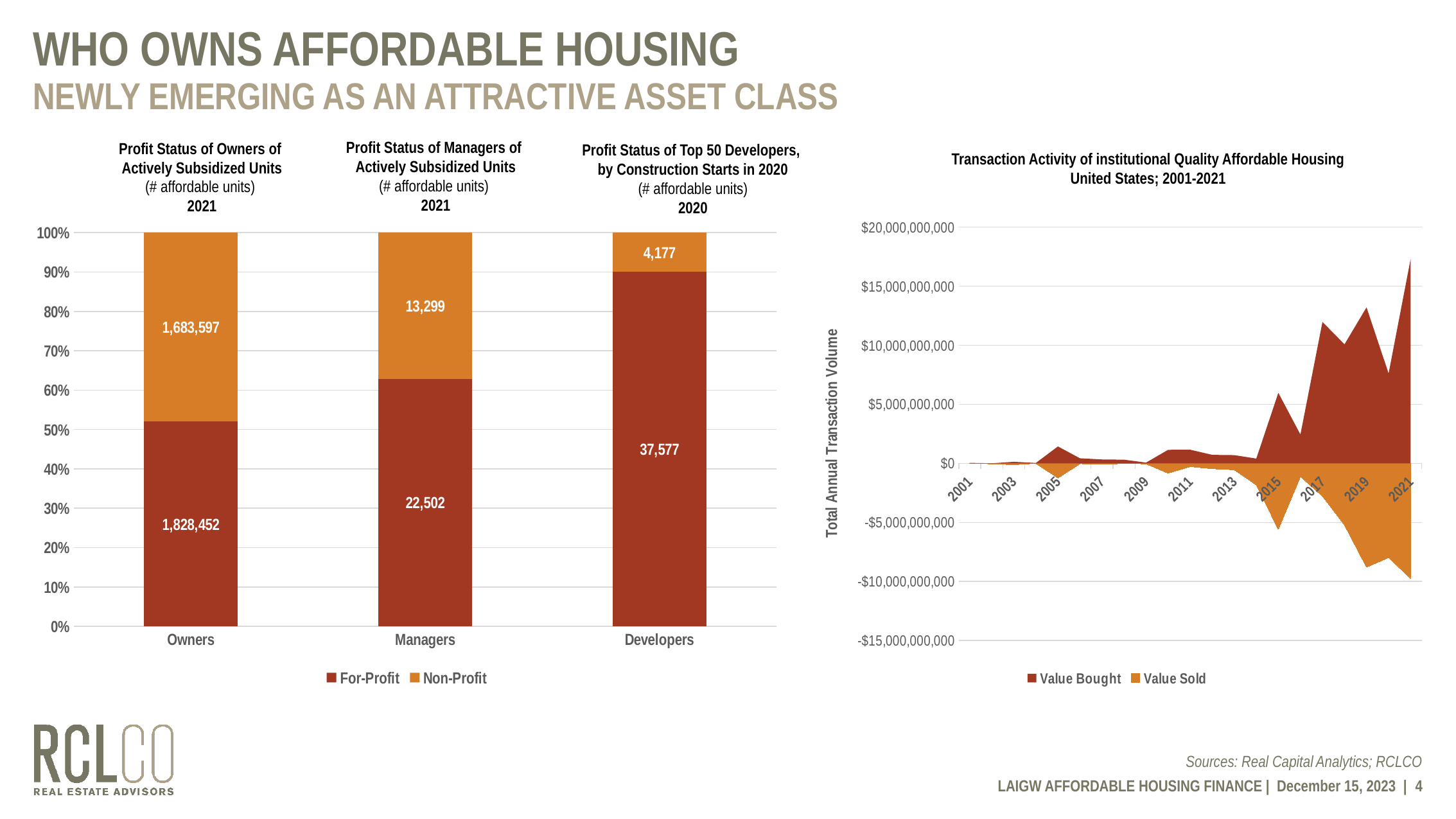
In the left stacked bar chart, which is larger for Managers, the For-Profit or the Non-Profit value? For-Profit In the left stacked bar chart, how many affordable units are For-Profit for Owners? 1,828,452 In the left stacked bar chart, what is the total number of affordable units for Developers (For-Profit plus Non-Profit)? 41,754 How many series does the legend of the left chart list? 2 In the left stacked bar chart, how many affordable units are Non-Profit for Managers? 13,299 In the right chart, what are the two series listed in the legend? Value Bought and Value Sold How many categories are shown on the x axis of the left stacked bar chart? 3 In the left stacked bar chart, what is the Non-Profit value for Developers? 4,177 In the right chart, is the Value Bought in 2021 greater or less than $15,000,000,000? greater What kind of chart is the 'Transaction Activity of institutional Quality Affordable Housing' chart on the right? Area chart In the left stacked bar chart, what is the difference between the For-Profit and Non-Profit values for Developers? 33,400 In the left stacked bar chart, which category has the highest Non-Profit value? Owners